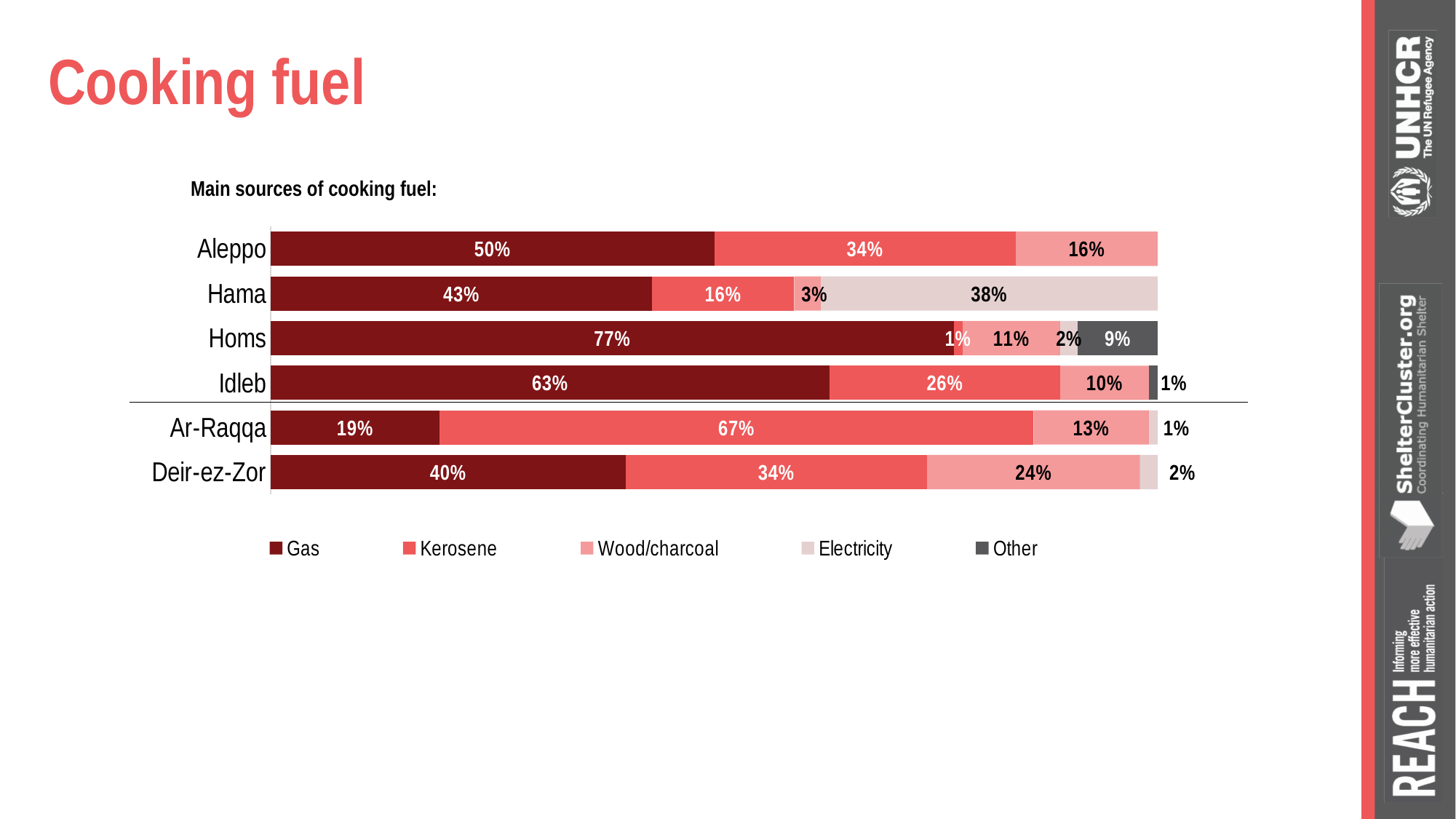
Which governorate has the lowest share of gas as a cooking fuel? Ar-Raqqa What is the electricity share for Hama? 38% How many fuel types does the legend list? 5 What percentage of households in Homs use gas as their main cooking fuel? 77% How many percentage points higher is the gas share in Aleppo than in Hama? 7 percentage points Which has a larger kerosene share, Aleppo or Idleb? Aleppo Which governorate has the highest share of gas as a cooking fuel? Homs What type of chart is shown on the slide? Stacked bar chart What is the 'Other' share for Homs? 9% What is the kerosene share for Ar-Raqqa? 67% What is the wood/charcoal share for Deir-ez-Zor? 24% How many governorates are shown in the chart? 6